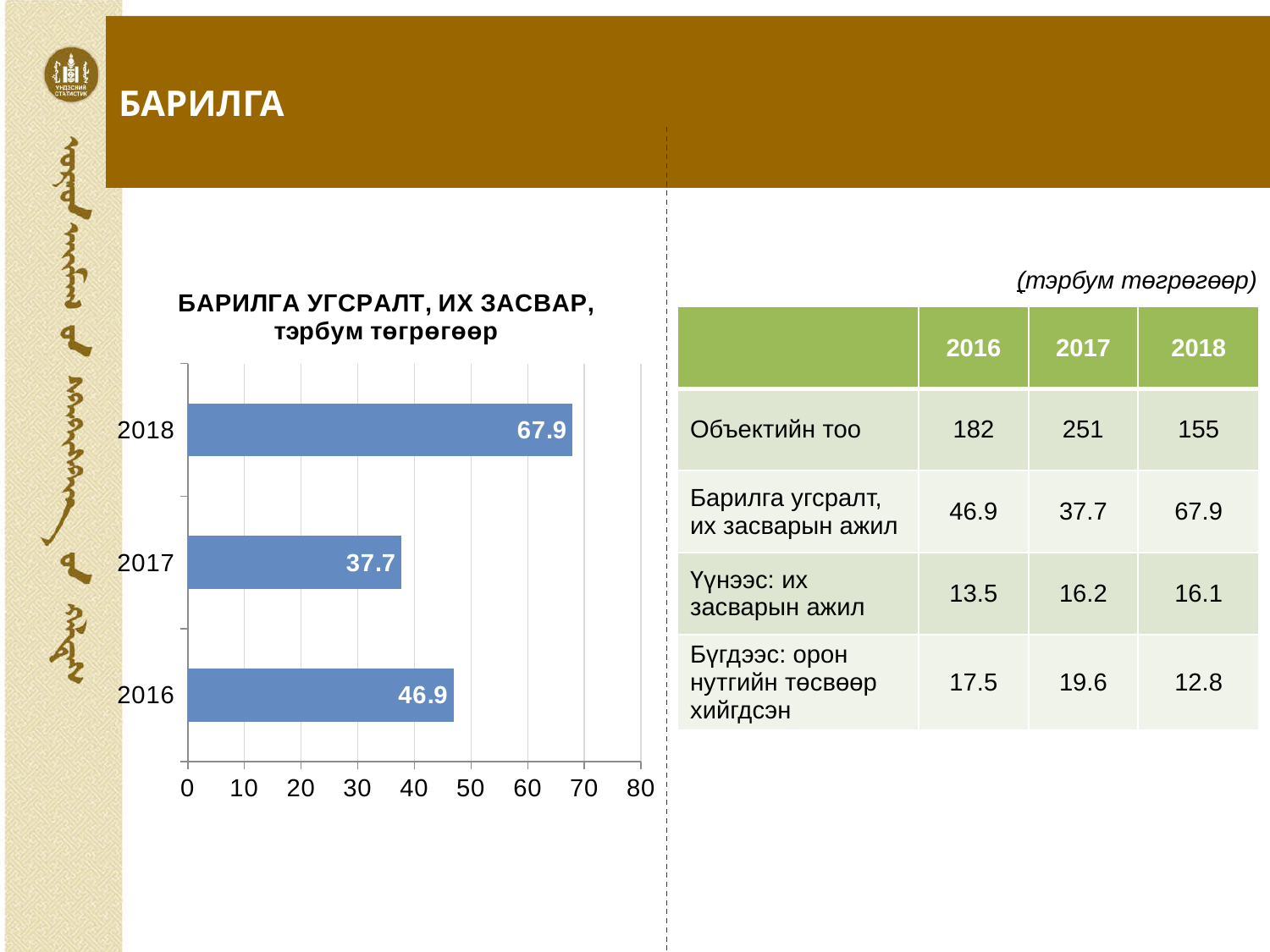
What is the difference between the values for 2018 and 2017? 30.2 Is the value for 2018 greater or less than 60? greater What kind of chart is shown on the slide? bar chart Which year has the lowest value in the chart? 2017 Which year has the highest value in the chart? 2018 How many bars are shown in the chart? 3 What is the difference between the values for 2016 and 2017? 9.2 What is the value for 2017 in the chart? 37.7 What is the value for 2018 in the chart? 67.9 Which is larger, the value for 2016 or the value for 2017? 2016 What is the title of the chart? БАРИЛГА УГСРАЛТ, ИХ ЗАСВАР, тэрбум төгрөгөөр What is the value for 2016 in the chart? 46.9